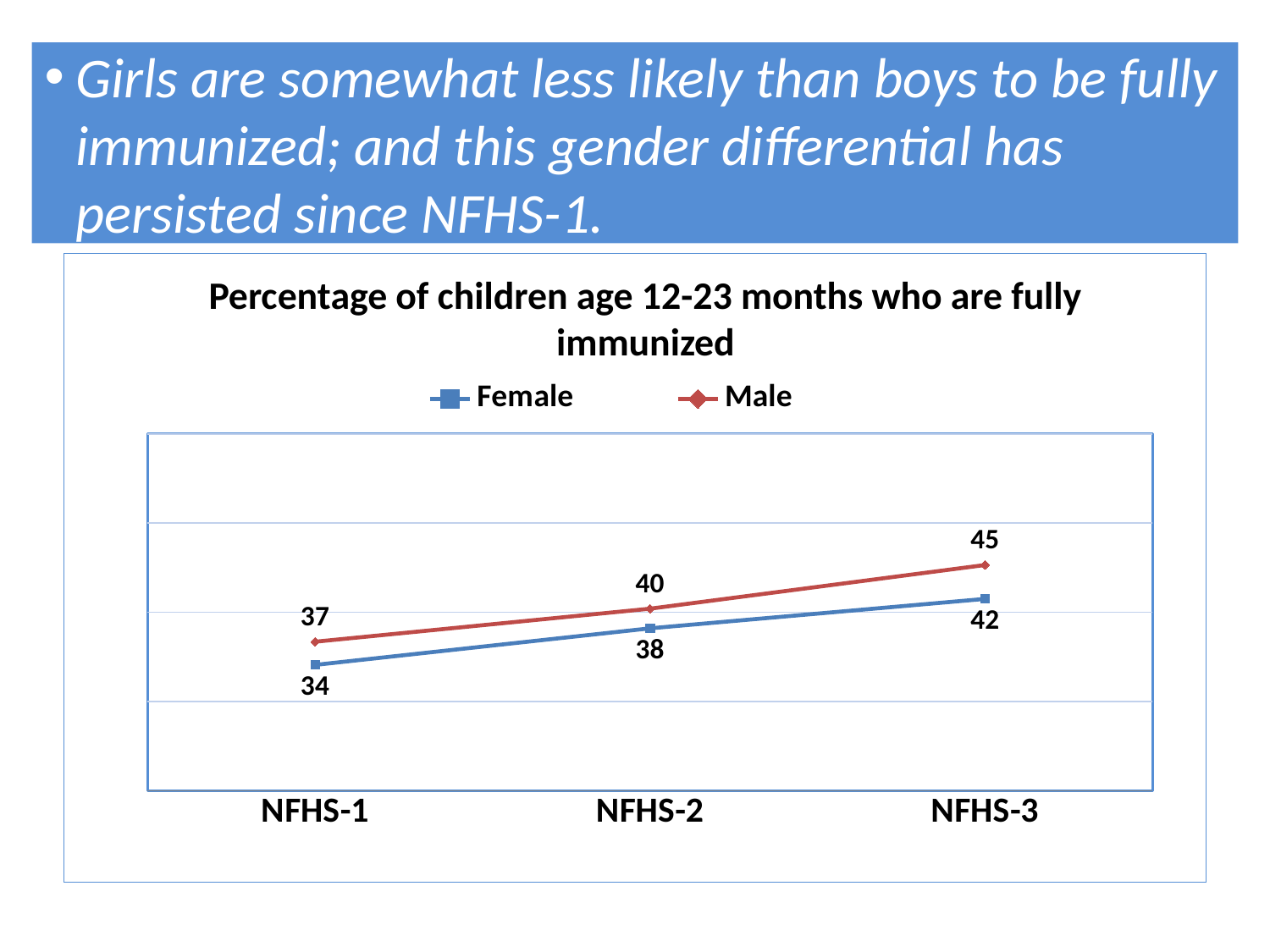
What is the Female value for NFHS-1? 34 How many surveys are shown on the x axis? 3 What kind of chart is shown? Line chart For which survey is the Female value lowest? NFHS-1 What is the difference between the Male and Female values for NFHS-3? 3 What is the difference between the Female values for NFHS-3 and NFHS-1? 8 What is the Male value for NFHS-1? 37 What is the Male value for NFHS-3? 45 How many series does the legend list? 2 For which survey is the Male value highest? NFHS-3 What is the Female value for NFHS-2? 38 Which is larger for NFHS-2, the Male value or the Female value? Male